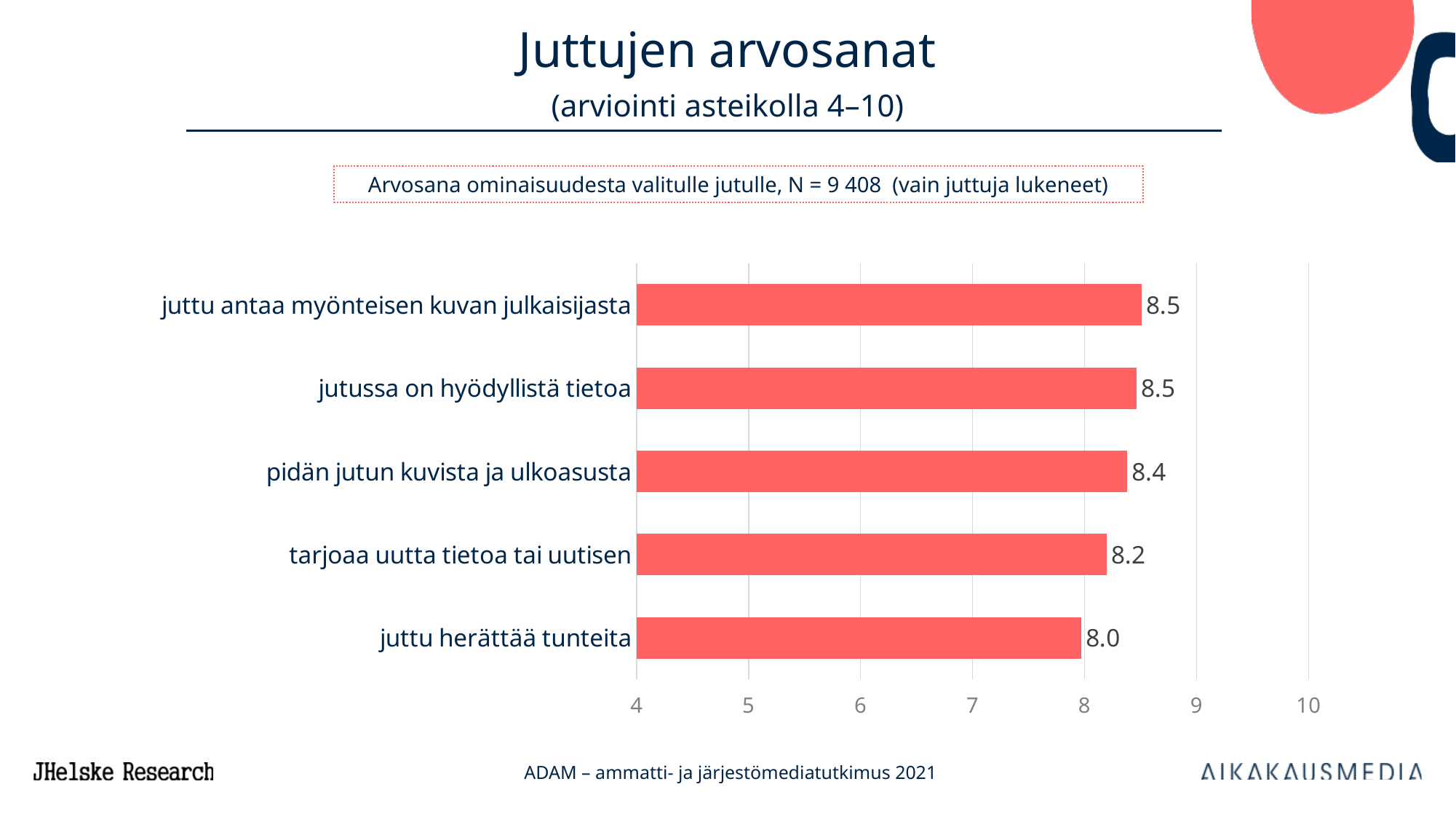
How many categories are shown in the chart? 5 Which is larger, the value for "pidän jutun kuvista ja ulkoasusta" or the value for "juttu herättää tunteita"? pidän jutun kuvista ja ulkoasusta What is the difference between the values for "juttu antaa myönteisen kuvan julkaisijasta" and "juttu herättää tunteita"? 0.5 Which category has the lowest value? juttu herättää tunteita What is the value for "pidän jutun kuvista ja ulkoasusta"? 8.4 What is the value for "jutussa on hyödyllistä tietoa"? 8.5 Is the value for "tarjoaa uutta tietoa tai uutisen" greater or less than 9? less What is the difference between the values for "pidän jutun kuvista ja ulkoasusta" and "tarjoaa uutta tietoa tai uutisen"? 0.2 What is the title of the chart on the slide? Juttujen arvosanat What kind of chart is shown on the slide? bar chart What is the value for "juttu herättää tunteita"? 8.0 What is the value for "tarjoaa uutta tietoa tai uutisen"? 8.2